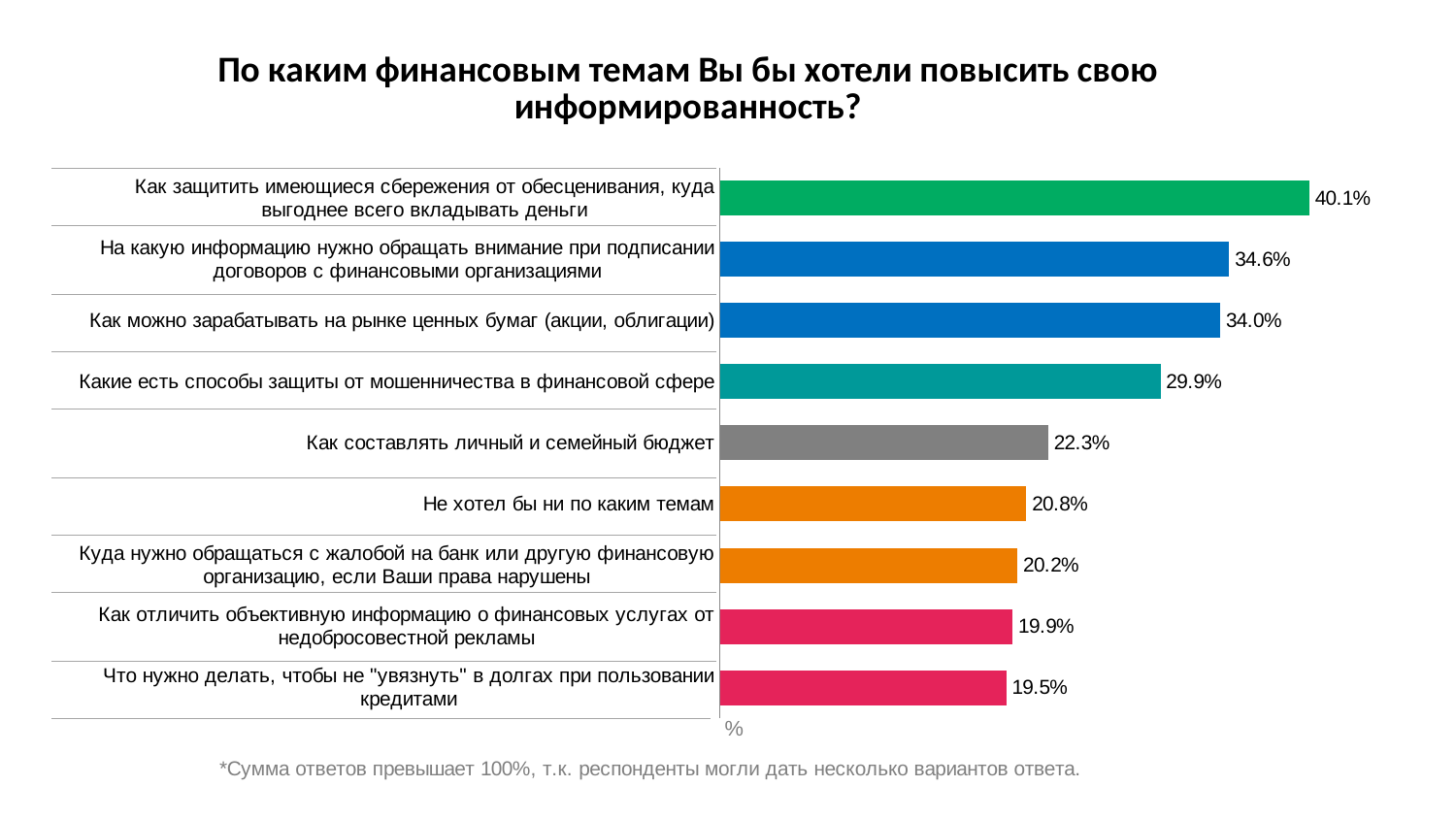
How many categories are shown in the chart? 9 What is the value for "Какие есть способы защиты от мошенничества в финансовой сфере"? 29.9% What is the value for "Не хотел бы ни по каким темам"? 20.8% Which category has the highest value? Как защитить имеющиеся сбережения от обесценивания, куда выгоднее всего вкладывать деньги What is the title of the chart? По каким финансовым темам Вы бы хотели повысить свою информированность? What is the difference between the values for "На какую информацию нужно обращать внимание при подписании договоров с финансовыми организациями" and "Как можно зарабатывать на рынке ценных бумаг (акции, облигации)"? 0.6% What is the value for "Как отличить объективную информацию о финансовых услугах от недобросовестной рекламы"? 19.9% What is the difference between the values for "Как защитить имеющиеся сбережения от обесценивания, куда выгоднее всего вкладывать деньги" and "Как составлять личный и семейный бюджет"? 17.8% What kind of chart is shown on the slide? Bar chart Which category has the lowest value? Что нужно делать, чтобы не "увязнуть" в долгах при пользовании кредитами What is the value for "Как составлять личный и семейный бюджет"? 22.3% Which is larger: the value for "Какие есть способы защиты от мошенничества в финансовой сфере" or the value for "Как составлять личный и семейный бюджет"? Какие есть способы защиты от мошенничества в финансовой сфере